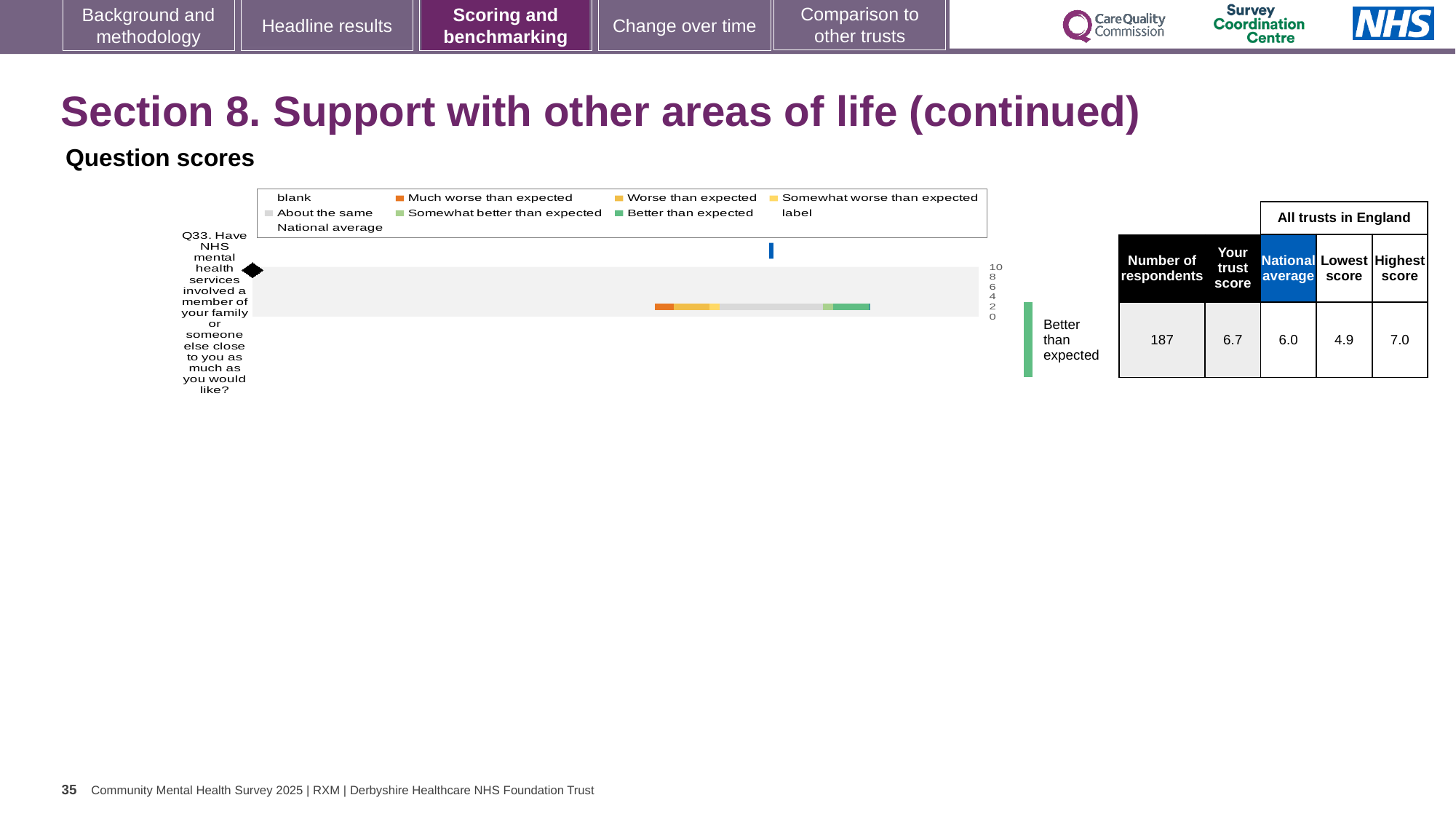
What is the lowest score among all trusts in England for Q33? 4.9 How many entries does the chart legend list? 9 What is the trust score for Q33 shown alongside the chart? 6.7 Which question is plotted in the chart? Q33. Have NHS mental health services involved a member of your family or someone else close to you as much as you would like? What is the difference between the highest score and the lowest score for Q33? 2.1 What kind of chart is shown under 'Question scores'? bar chart What is the national average for Q33 shown alongside the chart? 6.0 What is the number of respondents for Q33? 187 Which is larger for Q33, the trust score or the national average? trust score How many questions (categories) are plotted in the chart? 1 What is the benchmark category shown next to the chart for Q33? Better than expected